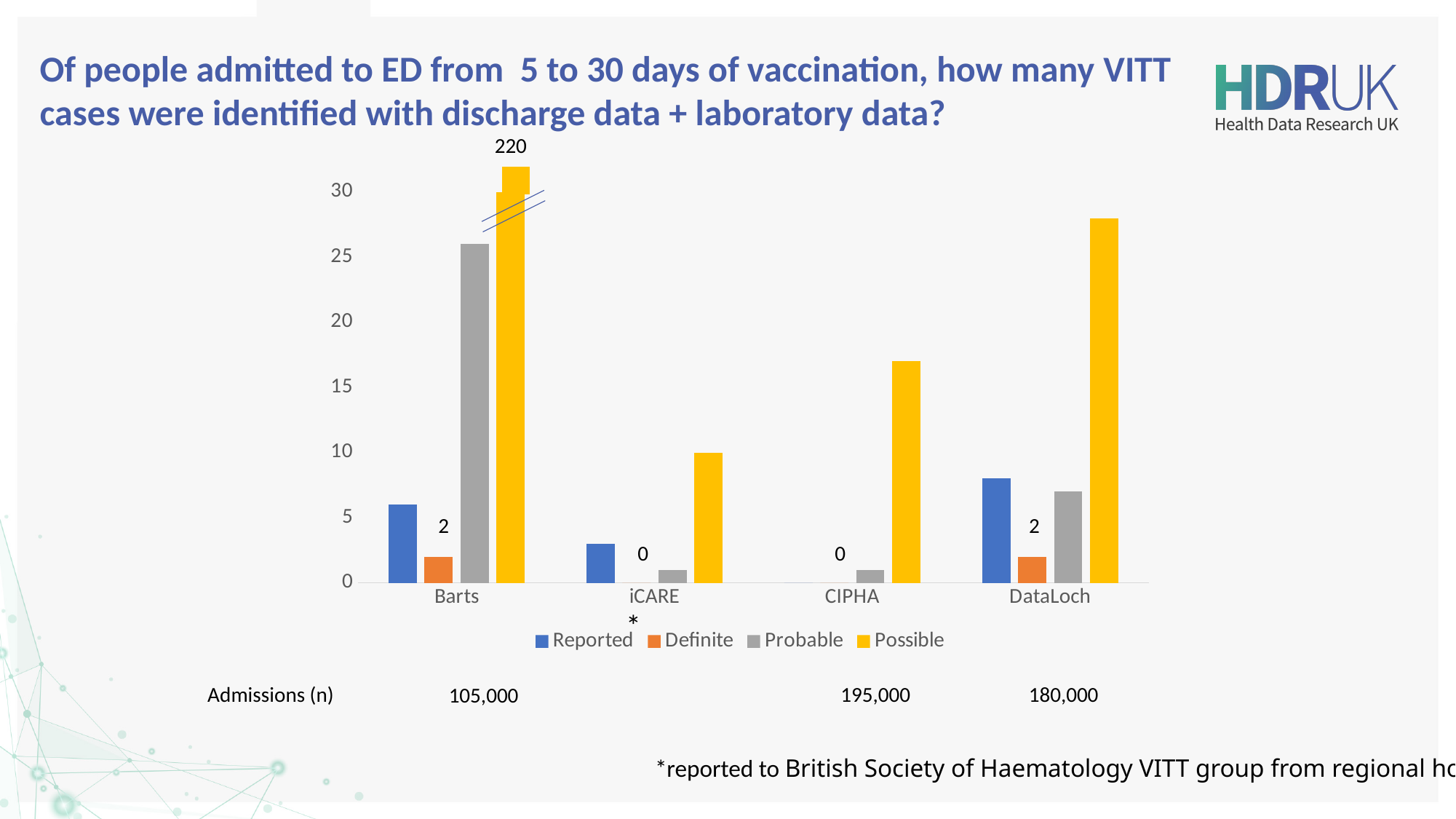
How many categories are shown on the x axis? 4 Is the Possible value for CIPHA greater or less than 15? greater What is the value of the Definite bar for CIPHA? 0 Is the Probable value for Barts greater or less than 20? greater Which category has the lowest Possible value? iCARE Which category has the highest Possible value? Barts What is the difference between the Definite values for Barts and iCARE? 2 How many series does the legend list? 4 Which is larger, the Reported value for DataLoch or the Reported value for Barts? DataLoch What is the value of the Possible bar for Barts? 220 What kind of chart is shown on the slide? Bar chart What is the value of the Definite bar for DataLoch? 2